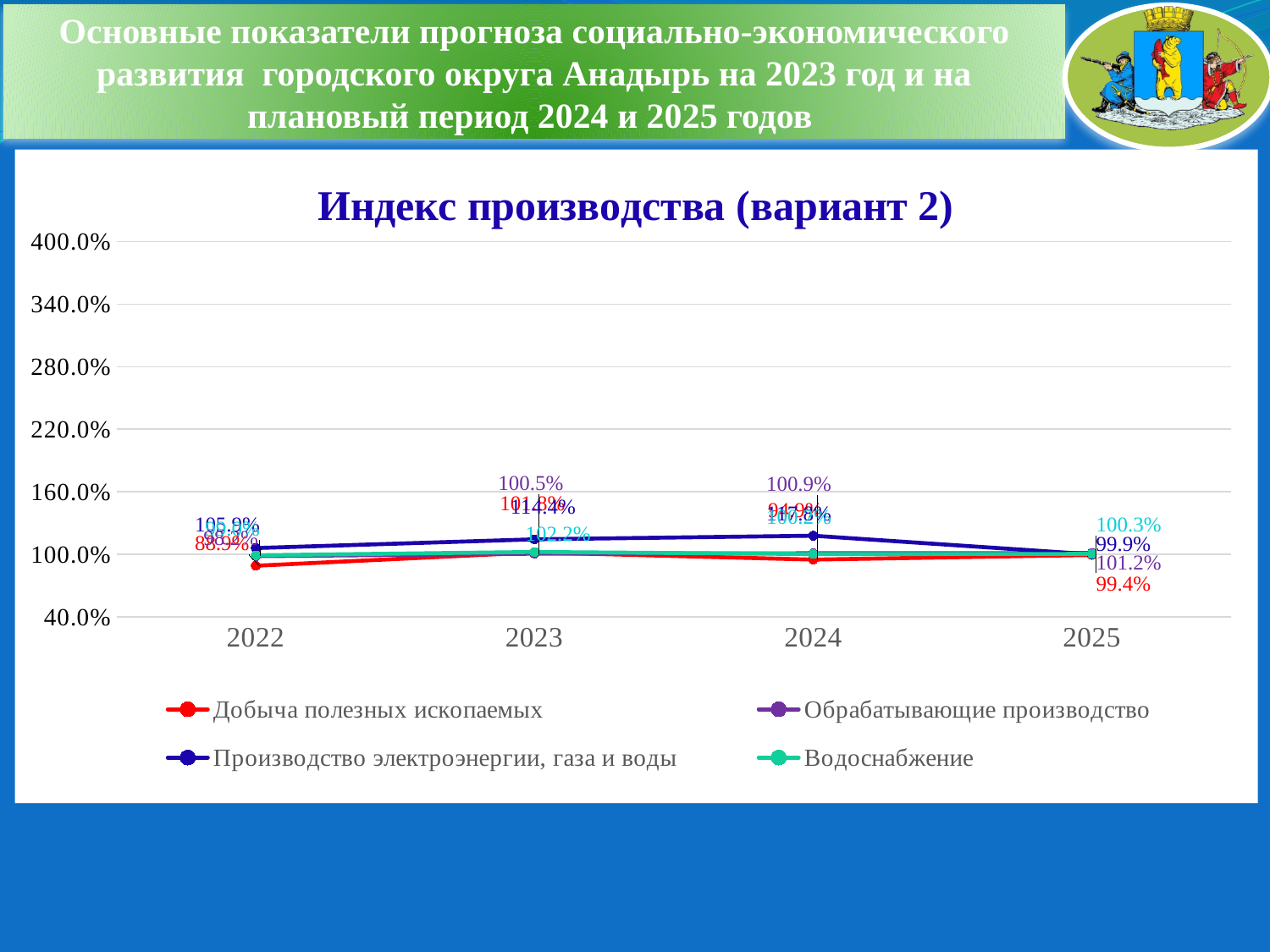
What is the title of the chart? Индекс производства (вариант 2) How many years are shown on the x axis? 4 Which series has the highest value in 2025? Обрабатывающие производство What is the value for Производство электроэнергии, газа и воды in 2025? 99.9% What is the value for Обрабатывающие производство in 2025? 101.2% What is the value for Водоснабжение in 2025? 100.3% What is the value for Добыча полезных ископаемых in 2022? 89.0% Is the value for Добыча полезных ископаемых in 2022 greater or less than 100.0%? less What is the value for Добыча полезных ископаемых in 2025? 99.4% What is the difference between Обрабатывающие производство and Добыча полезных ископаемых in 2025? 1.8 percentage points How many series does the legend list? 4 What kind of chart is shown on the slide? line chart